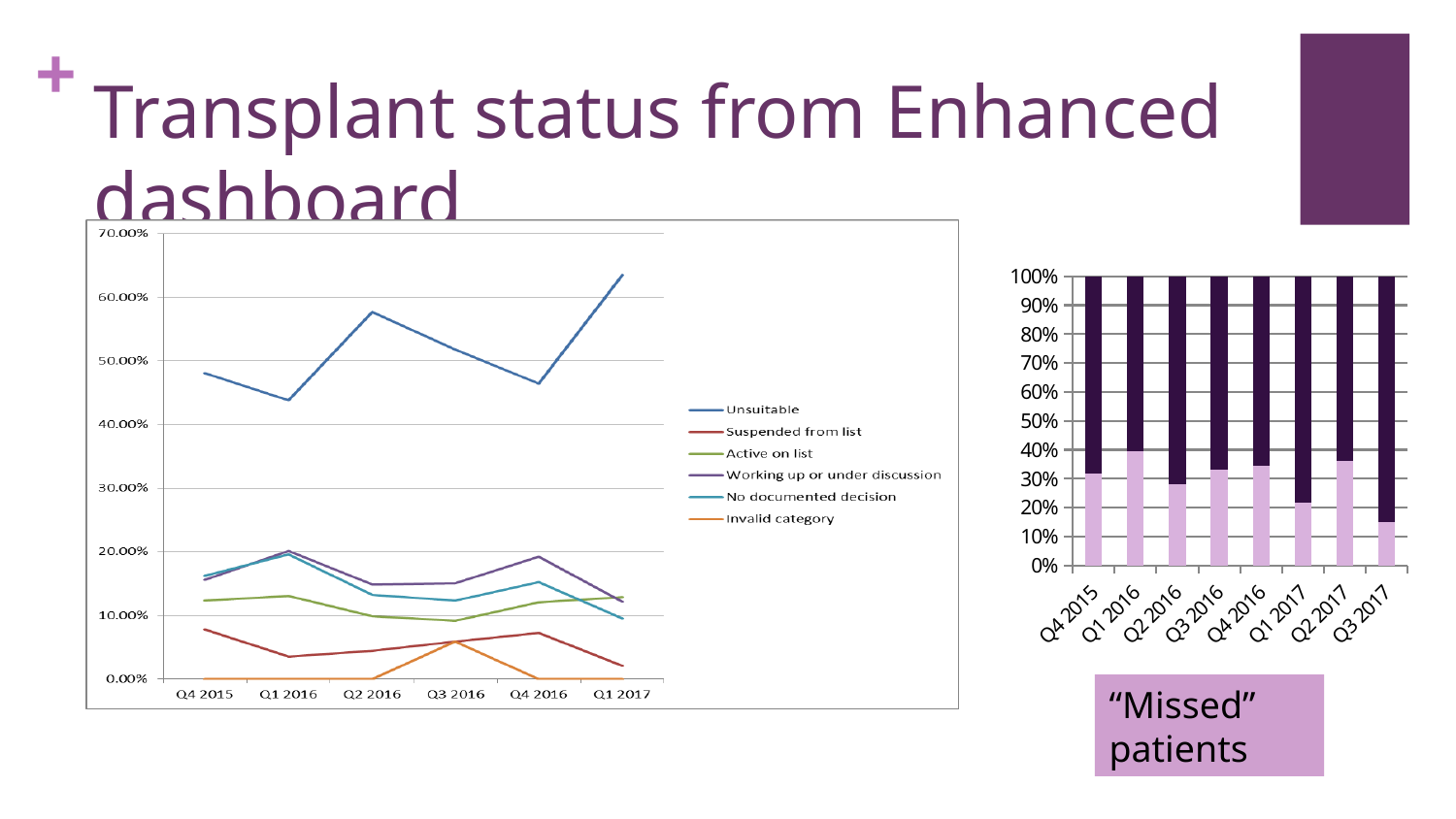
On the left line chart, is the value for Suspended from list in Q4 2015 greater or less than 10.00%? less On the right-hand stacked bar chart, in which quarter is the light pink segment the smallest? Q3 2017 On the left line chart, which series has the highest values across all quarters? Unsuitable On the left line chart, how many series does the legend list? 6 On the left line chart, in which quarter does the Unsuitable series reach its highest value? Q1 2017 On the left line chart, is the value for Unsuitable in Q1 2017 greater or less than 60.00%? greater On the right-hand stacked bar chart, how many quarters are shown on the x axis? 8 On the left line chart, in which quarter is the Unsuitable series at its lowest? Q1 2016 On the left line chart, which is larger: the Unsuitable value in Q4 2016 or in Q1 2017? Q1 2017 On the left line chart, how many quarters are shown on the x axis? 6 What kind of chart is the right-hand chart above the "Missed" patients label? Stacked bar chart On the left line chart, is the value for Unsuitable in Q1 2016 greater or less than 50.00%? less